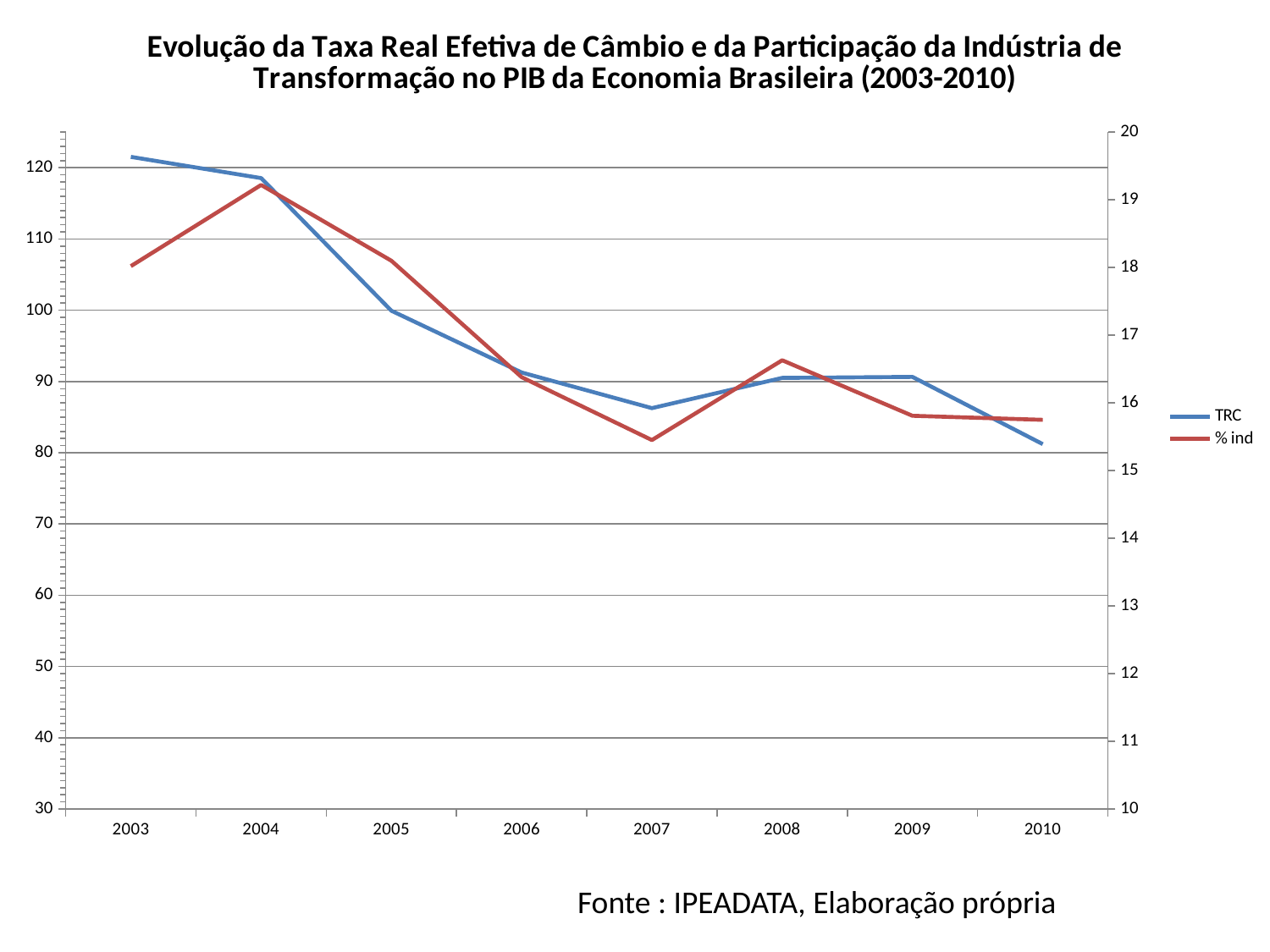
Is the TRC value for 2003 greater or less than 120? greater In which year is the TRC series at its lowest? 2010 Does the TRC series overall rise or fall from 2003 to 2010? fall Which series is drawn in red according to the legend? % ind In which year is the TRC series at its highest? 2003 How many series does the legend list? 2 Is the TRC value for 2007 greater or less than 90? less In which year is the % ind series at its highest? 2004 What kind of chart is shown on the slide? line chart How many years are plotted along the x axis? 8 In which year is the % ind series at its lowest? 2007 Is the % ind value for 2007 greater or less than 16? less